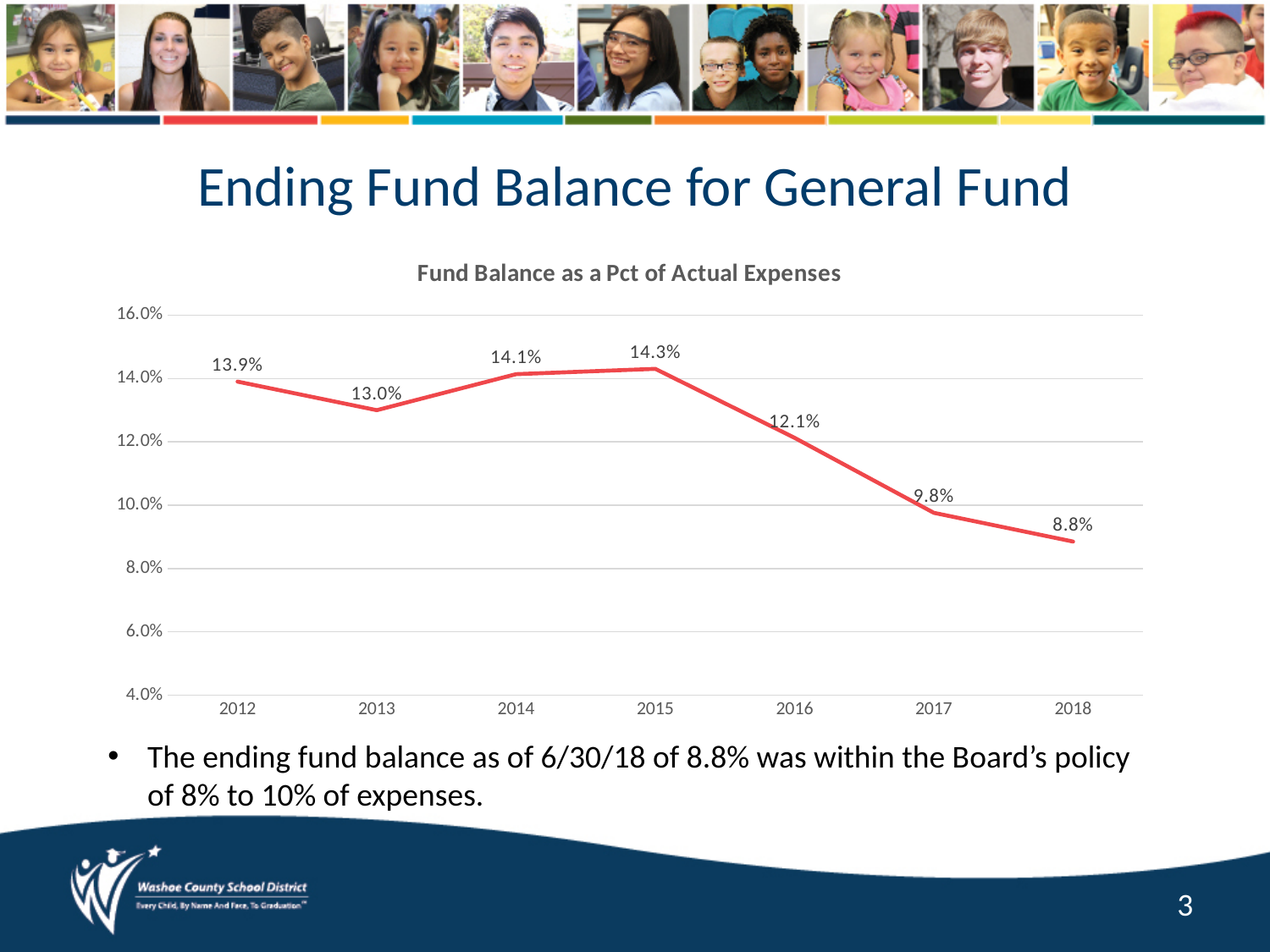
What is the difference between the fund balance percentage in 2015 and in 2018? 5.5% Which year has the lowest fund balance as a percent of actual expenses? 2018 What is the fund balance as a percent of actual expenses in 2013? 13.0% What is the fund balance as a percent of actual expenses in 2015? 14.3% How many years are plotted on the chart? 7 What kind of chart is shown on the slide? Line chart Does the fund balance percentage rise or fall from 2015 to 2018? Fall Is the value for 2016 greater or less than 12.0%? greater Which year has a higher fund balance percentage, 2012 or 2014? 2014 Which year has the highest fund balance as a percent of actual expenses? 2015 What is the fund balance as a percent of actual expenses in 2018? 8.8% What is the title of the chart? Fund Balance as a Pct of Actual Expenses